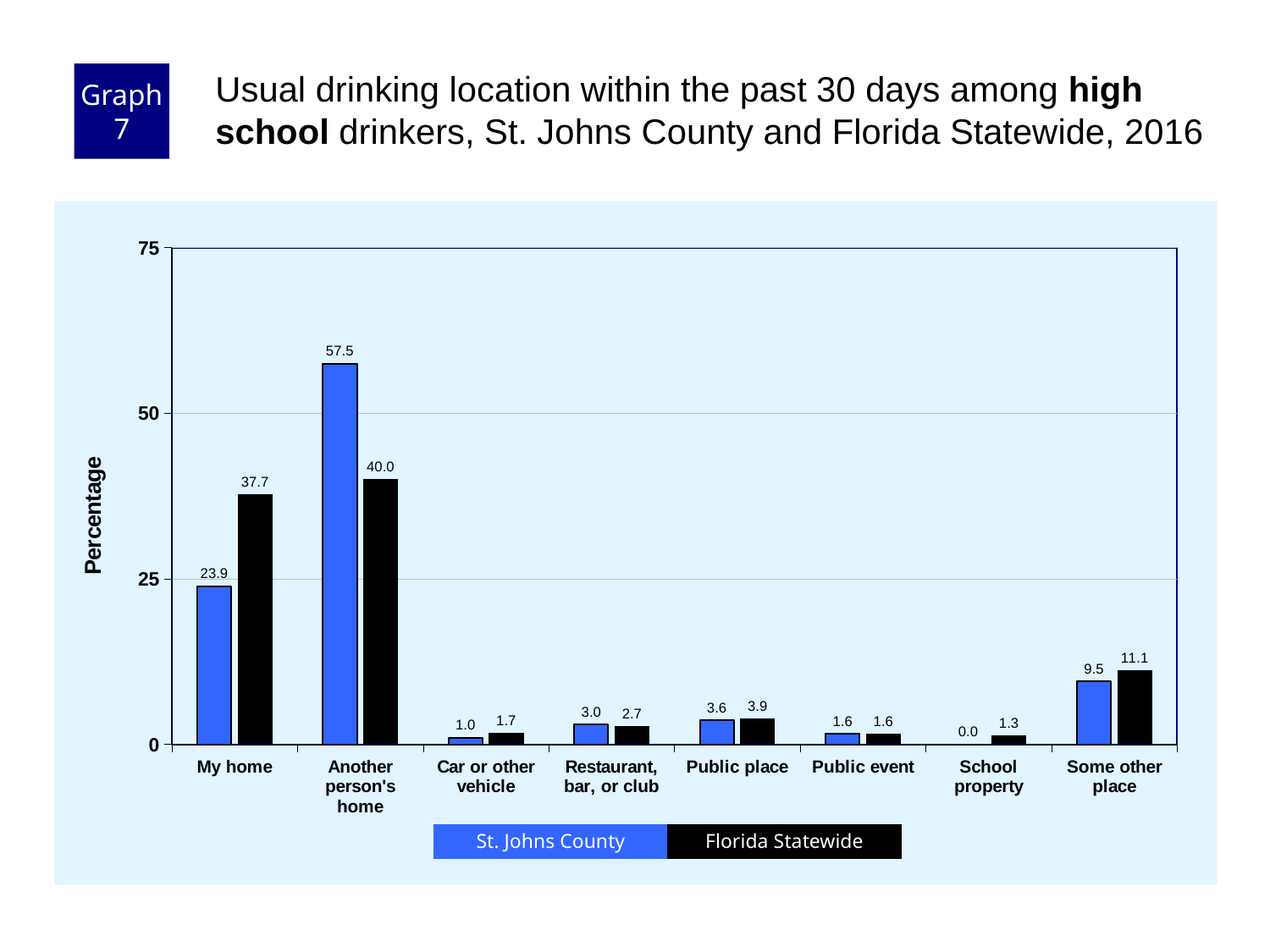
What is the label on the y axis? Percentage What kind of chart is shown on the slide? Bar chart What is the difference between the St. Johns County and Florida Statewide values for "Another person's home"? 17.5 What is the St. Johns County value for "School property"? 0.0 How many series does the legend list? 2 Which category has the highest St. Johns County value? Another person's home Is the St. Johns County value for "Another person's home" greater or less than 50? greater How many location categories are shown on the x axis? 8 What is the St. Johns County value for "Another person's home"? 57.5 What is the Florida Statewide value for "My home"? 37.7 Which category has the lowest Florida Statewide value? School property Which is larger for "My home": St. Johns County or Florida Statewide? Florida Statewide